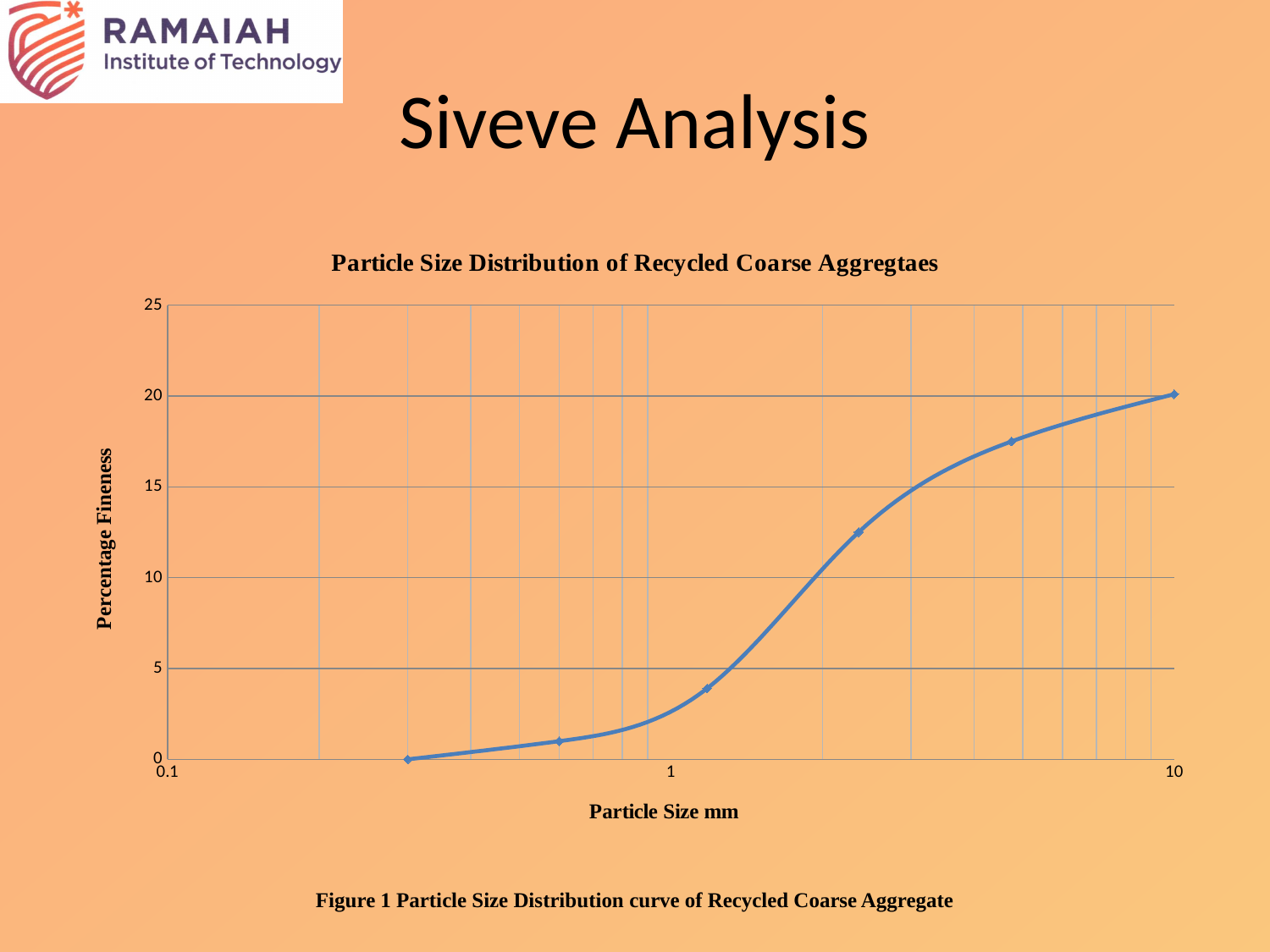
Is the percentage fineness of the second plotted point from the left greater or less than 5? less What is the label of the y axis? Percentage Fineness What is the title of the chart? Particle Size Distribution of Recycled Coarse Aggregtaes At which particle size on the x axis is the percentage fineness highest? 10 Is the percentage fineness of the second plotted point from the right greater or less than 15? greater What is the maximum value shown on the y axis? 25 Is the percentage fineness at a particle size of 10 mm greater or less than 15? greater Does the percentage fineness rise or fall as particle size increases along the x axis? rise What type of chart is shown on the slide? line chart Which has the higher percentage fineness: the leftmost plotted point or the point at 10 mm? the point at 10 mm How many data points are plotted on the line? 6